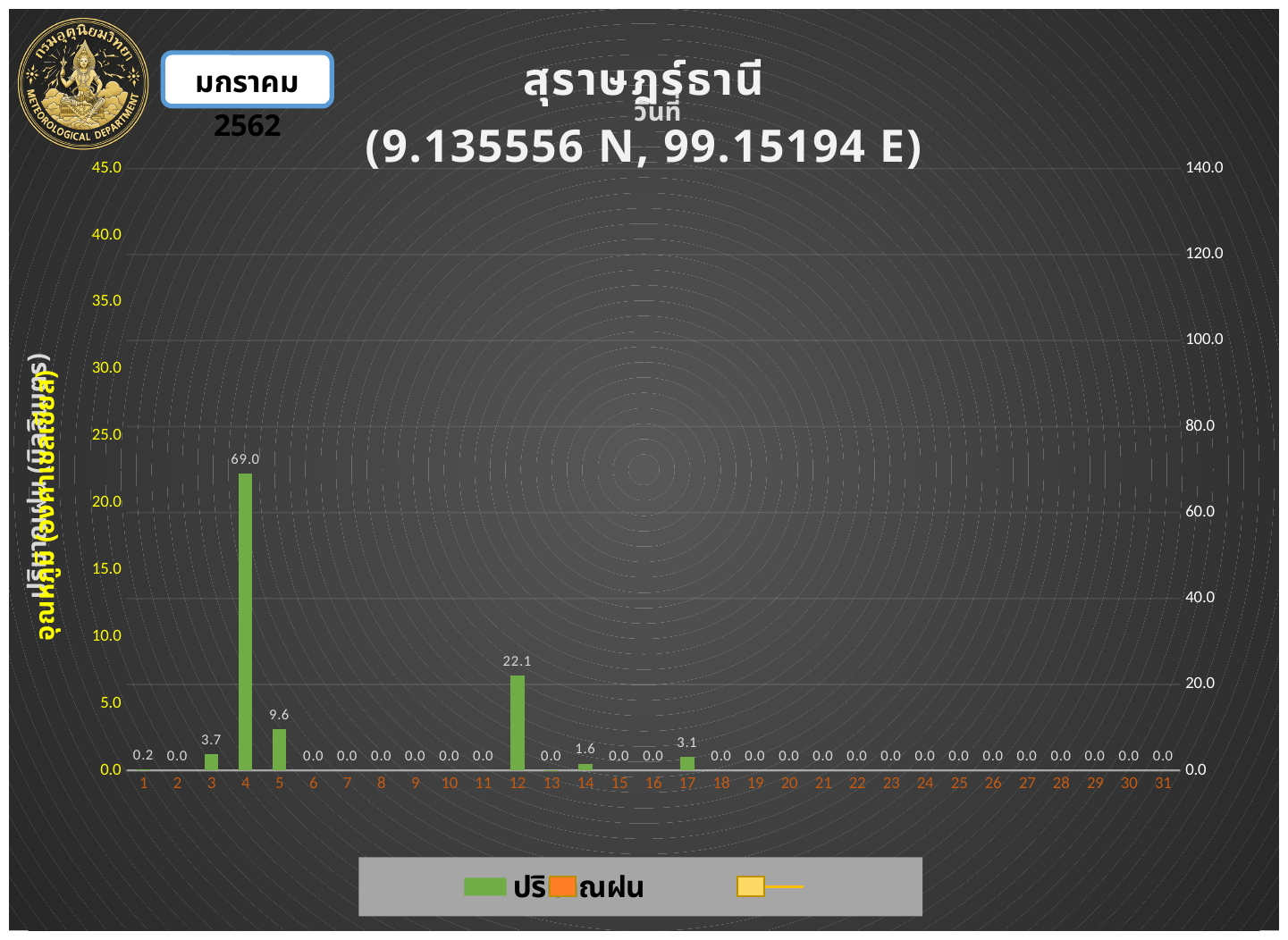
What type of chart is shown on the slide? bar chart What is the difference between the rainfall values for day 5 and day 3? 5.9 What is the difference between the rainfall values for day 4 and day 12? 46.9 What coordinates are given in the chart title? 9.135556 N, 99.15194 E What is the rainfall value shown for day 5? 9.6 Which day has the highest rainfall value? 4 Which has a larger rainfall value, day 14 or day 17? day 17 What is the rainfall value shown for day 1? 0.2 What is the rainfall value shown for day 12? 22.1 What is the rainfall value shown for day 4? 69.0 How many days are shown on the x axis? 31 What is the rainfall value shown for day 17? 3.1